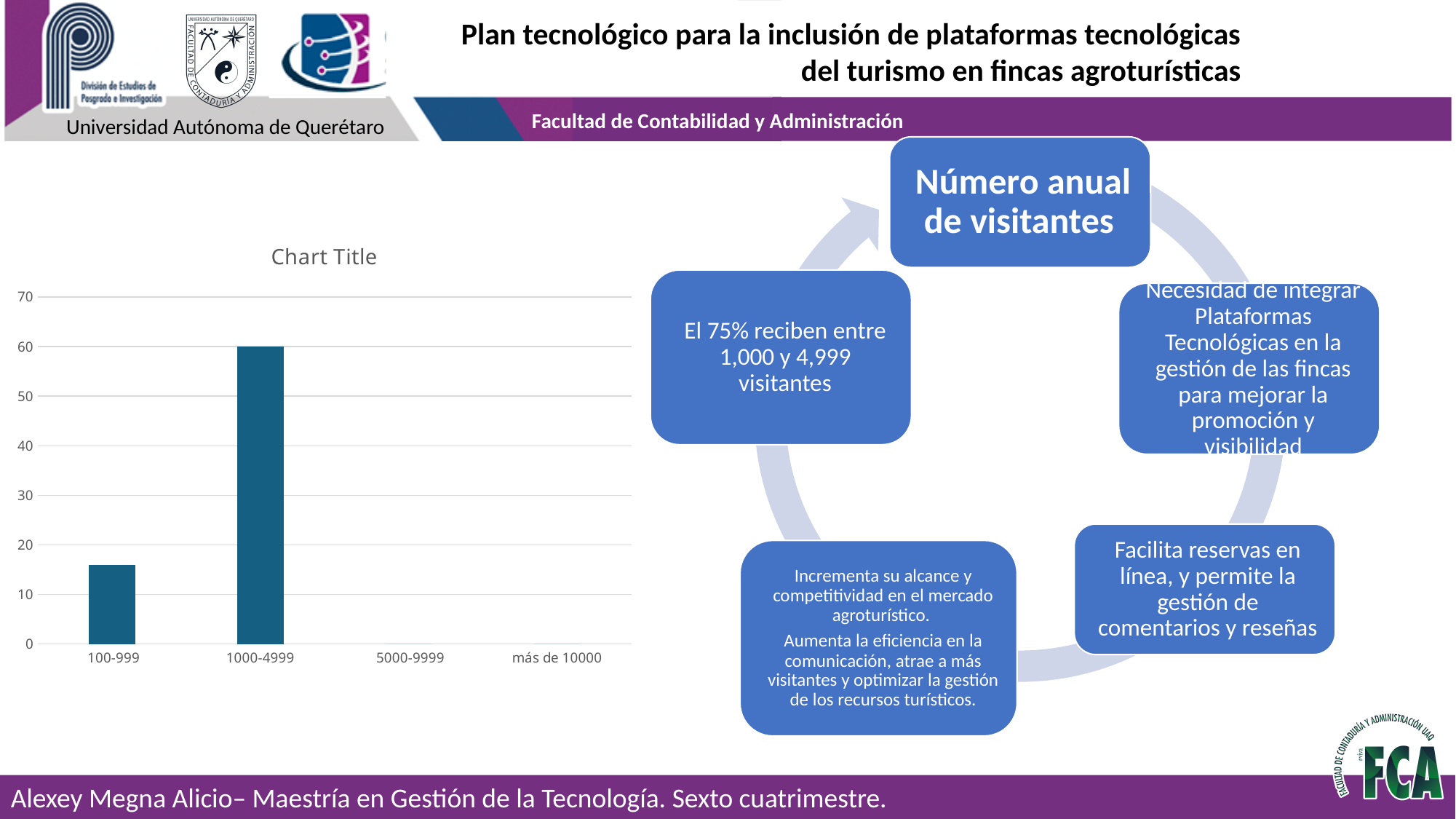
Is the value for 1000-4999 greater or less than 50? greater Is the value for 100-999 greater or less than 20? less What kind of chart is shown on the slide? bar chart What is the highest value shown on the y axis of the chart? 70 Does the 5000-9999 category show a visible bar in the chart? No Which category has the highest value? 1000-4999 Is the value for 100-999 greater or less than 10? greater How many categories are shown on the x axis of the chart? 4 What is the title of the chart? Chart Title What is the value for the 1000-4999 category? 60 Which is larger, the value for 100-999 or the value for 1000-4999? 1000-4999